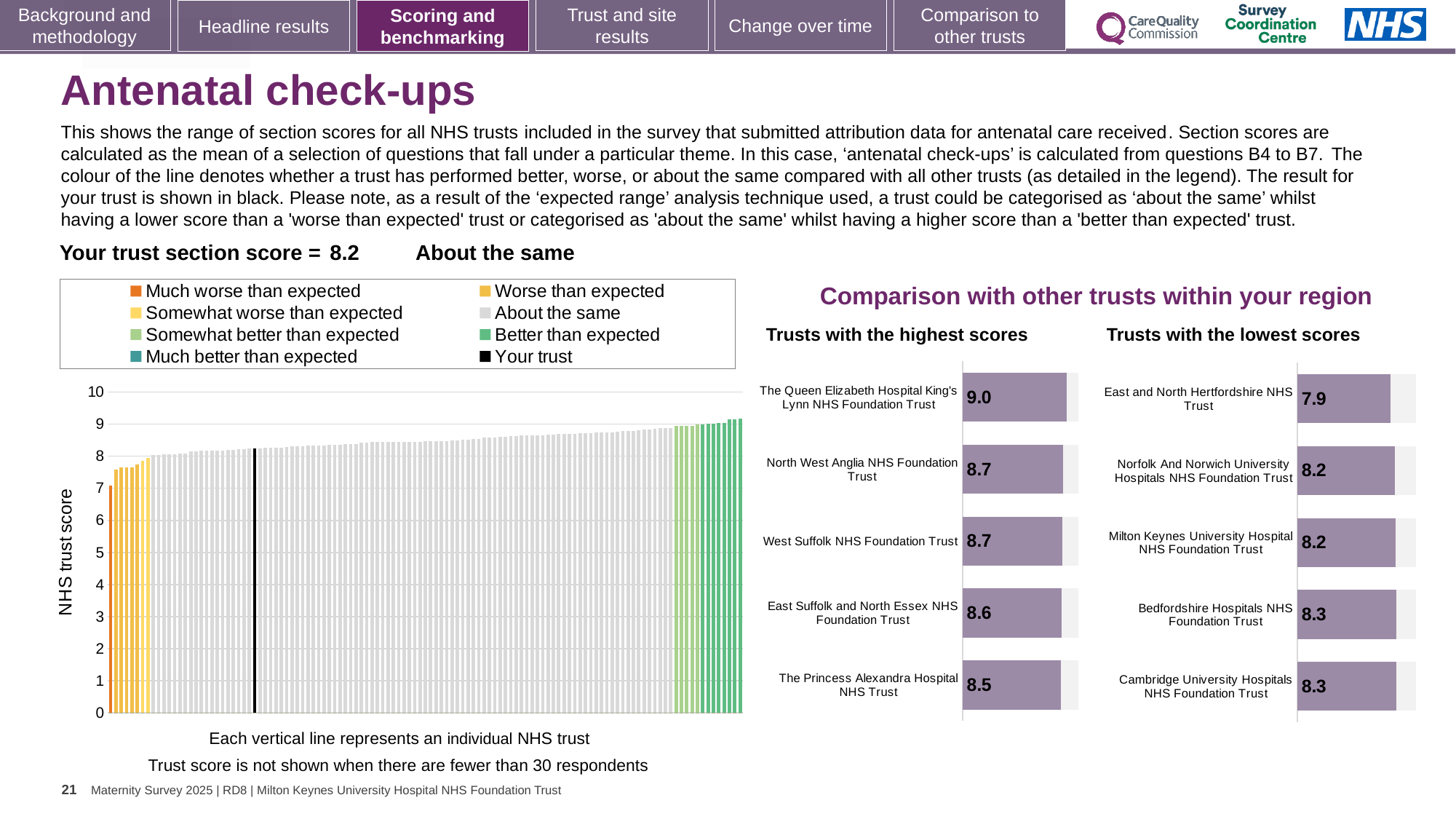
In the 'Trusts with the lowest scores' chart, what is the difference between the scores of Cambridge University Hospitals NHS Foundation Trust and East and North Hertfordshire NHS Trust? 0.4 In the 'Trusts with the lowest scores' chart, which trust has the lowest score? East and North Hertfordshire NHS Trust In the large chart on the left, do the NHS trust scores rise or fall from left to right? Rise In the 'Trusts with the lowest scores' chart, what is the score for Milton Keynes University Hospital NHS Foundation Trust? 8.2 How many entries does the legend above the large chart on the left list? 8 In the 'Trusts with the highest scores' chart, what is the difference between the scores of The Queen Elizabeth Hospital King's Lynn NHS Foundation Trust and The Princess Alexandra Hospital NHS Trust? 0.5 In the 'Trusts with the highest scores' chart, which has the larger score: North West Anglia NHS Foundation Trust or East Suffolk and North Essex NHS Foundation Trust? North West Anglia NHS Foundation Trust In the 'Trusts with the highest scores' chart, which trust has the highest score? The Queen Elizabeth Hospital King's Lynn NHS Foundation Trust How many trusts are shown in the 'Trusts with the highest scores' chart? 5 In the 'Trusts with the highest scores' chart, what is the score for The Queen Elizabeth Hospital King's Lynn NHS Foundation Trust? 9.0 In the 'Trusts with the highest scores' chart, what is the score for The Princess Alexandra Hospital NHS Trust? 8.5 What kind of chart is the large chart on the left showing NHS trust scores? Bar chart